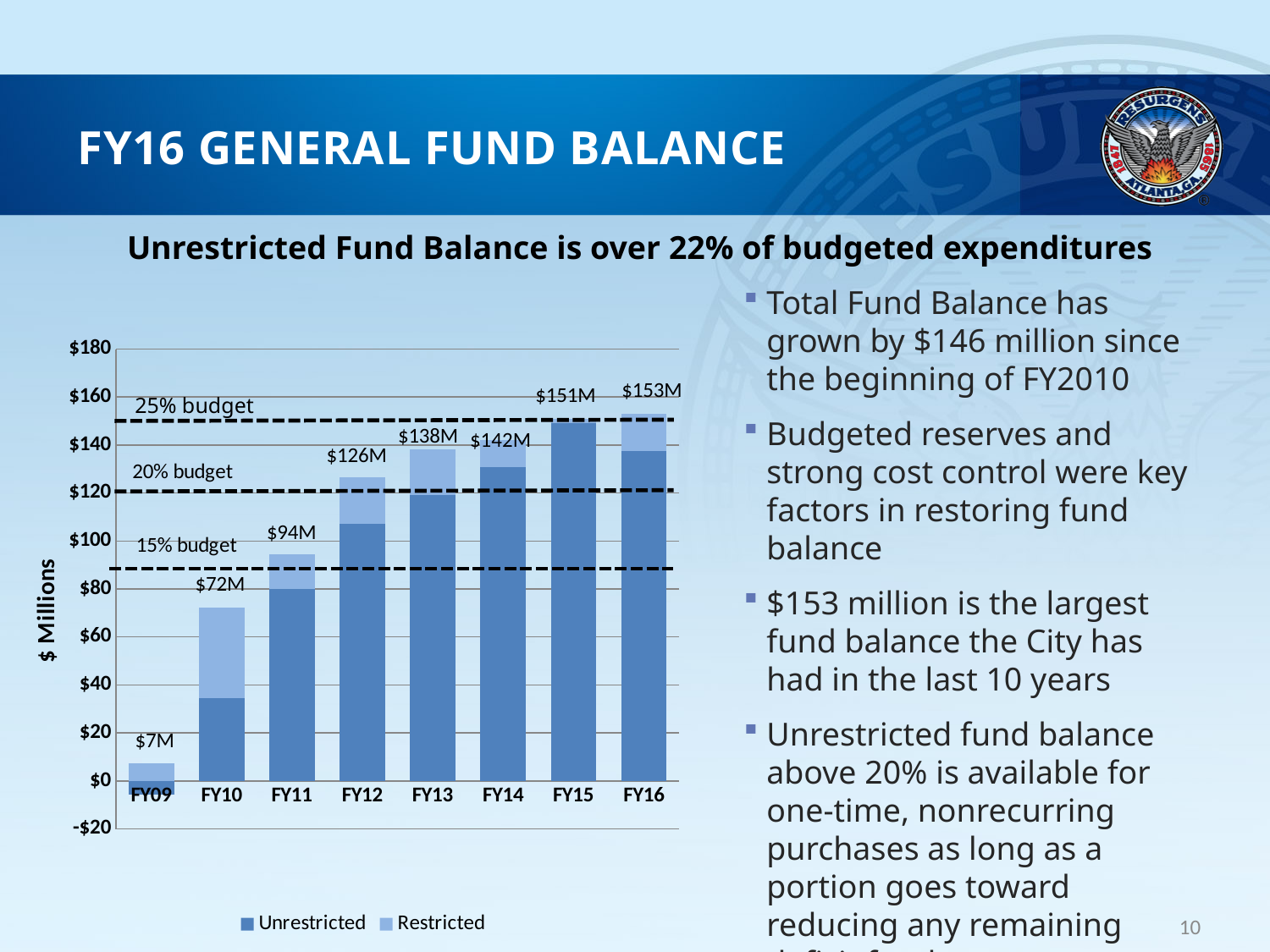
How many fiscal years are shown on the x axis? 8 What is the total fund balance labeled for FY09? $7M What is the total fund balance labeled for FY12? $126M Do the total fund balances rise or fall from FY09 to FY16? Rise What is the difference between the total fund balance in FY16 and FY10? $81M What kind of chart is shown on the slide? Stacked bar chart Is the Unrestricted value for FY16 greater or less than $120? greater How many series does the legend list? 2 Which fiscal year has the lowest total fund balance? FY09 Which fiscal year has the highest total fund balance? FY16 Which is larger, the total fund balance in FY13 or FY14? FY14 What is the total fund balance labeled for FY16? $153M